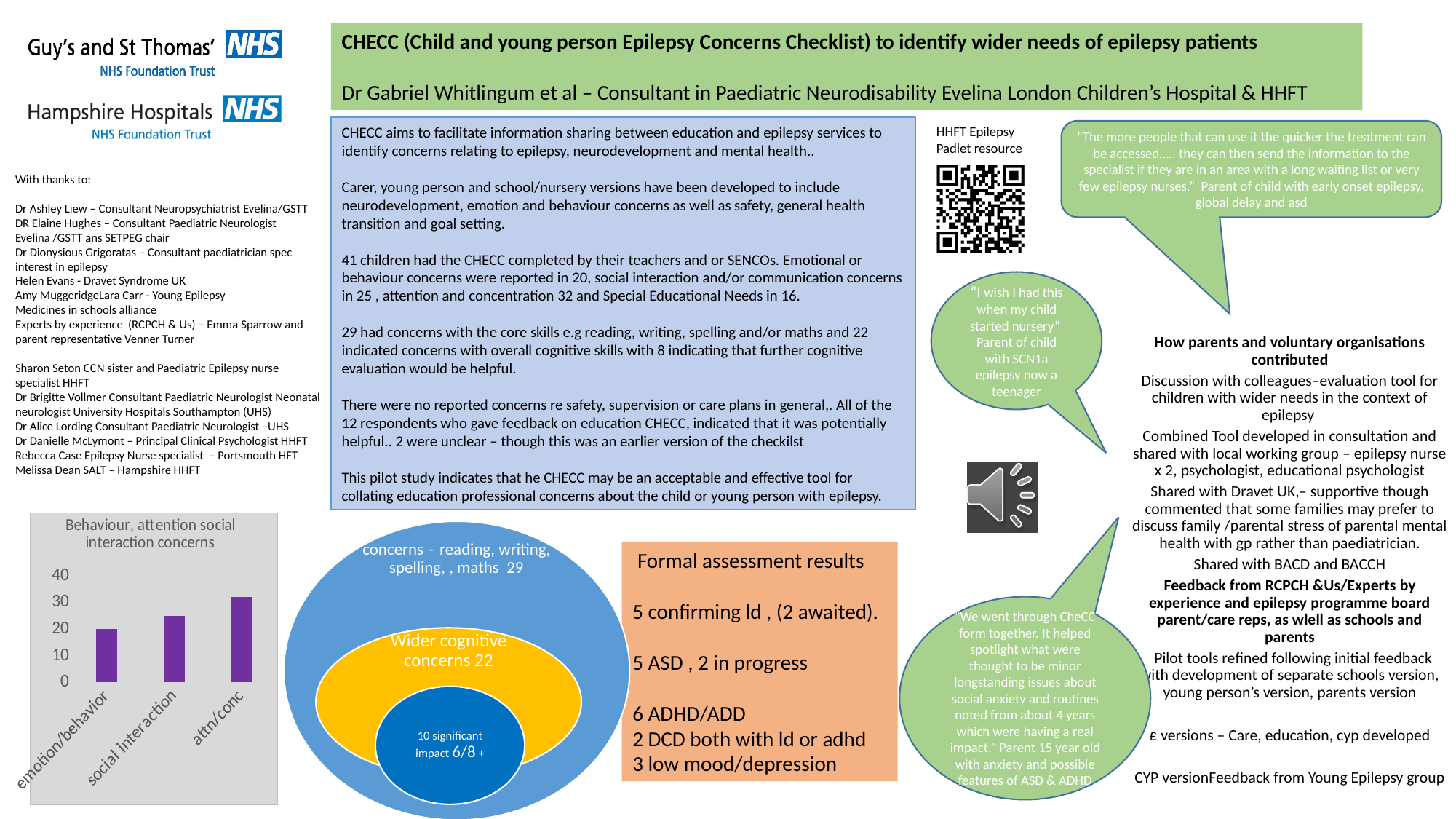
What colour are the bars in the chart? purple Which is larger in the bar chart, social interaction or emotion/behavior? social interaction Do the bar values rise or fall from left to right across the categories? rise Is the value for social interaction greater or less than 20? greater Is the value for attn/conc greater or less than 30? greater Which category has the lowest bar in the chart? emotion/behavior Is the value for social interaction greater or less than 30? less Which is larger in the bar chart, attn/conc or social interaction? attn/conc Which category has the highest bar in the chart? attn/conc How many categories are shown in the bar chart? 3 What type of chart is shown on the slide? bar chart What is the title of the bar chart? Behaviour, attention social interaction concerns